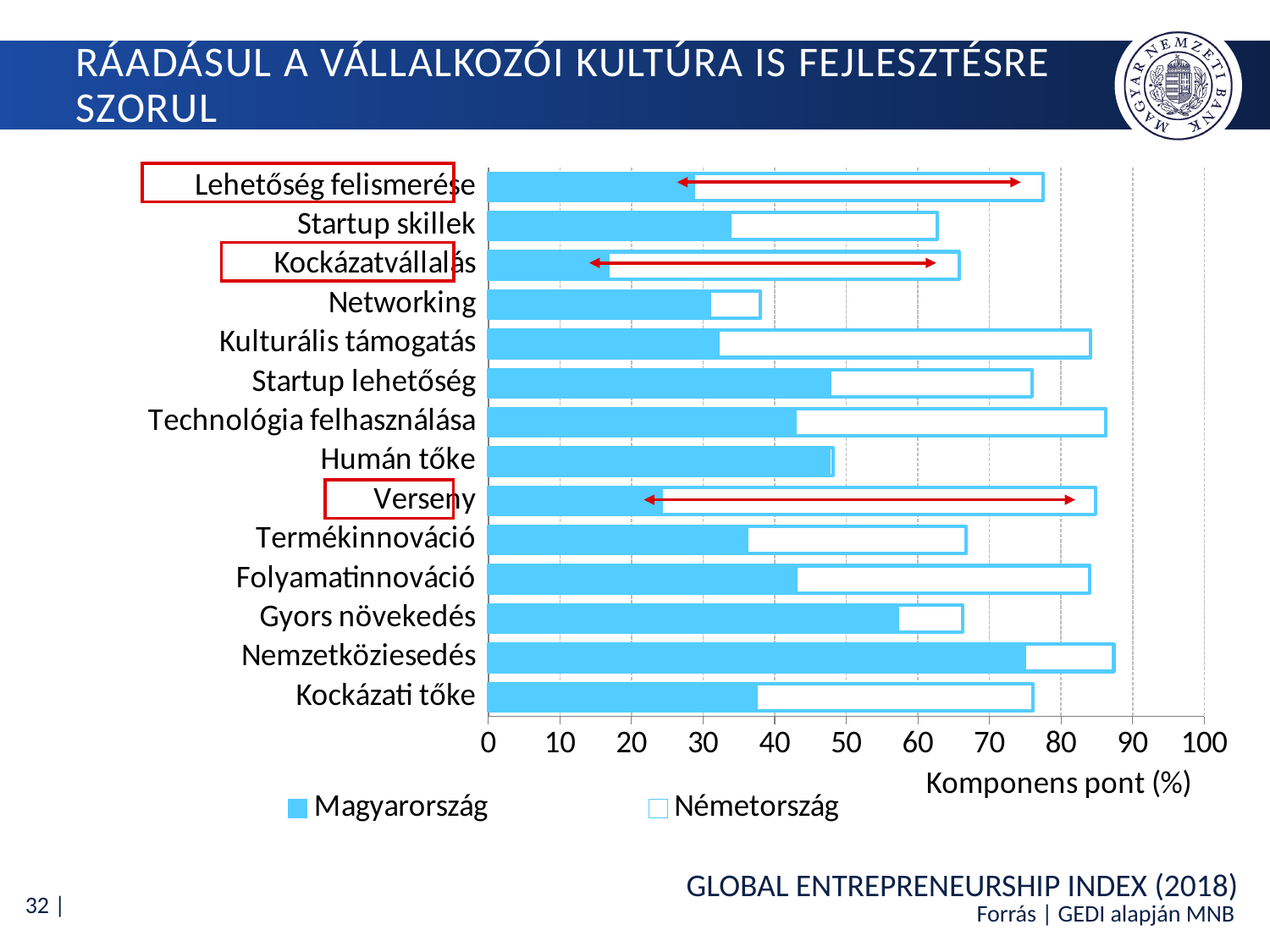
Is the value for Magyarország in Nemzetköziesedés greater or less than 70? greater Which is larger for Verseny: the value for Magyarország or the value for Németország? Németország Which category has the lowest value for Magyarország? Kockázatvállalás Which category has the lowest value for Németország? Networking Which series is drawn as a filled blue bar according to the legend? Magyarország How many categories are plotted on the y axis of the chart? 14 What kind of chart is shown on the slide? bar chart Is the value for Németország in Verseny greater or less than 80? greater Which category has the highest value for Magyarország? Nemzetköziesedés How many series does the legend list? 2 Is the value for Magyarország in Kockázatvállalás greater or less than 20? less What is the title of the x axis? Komponens pont (%)